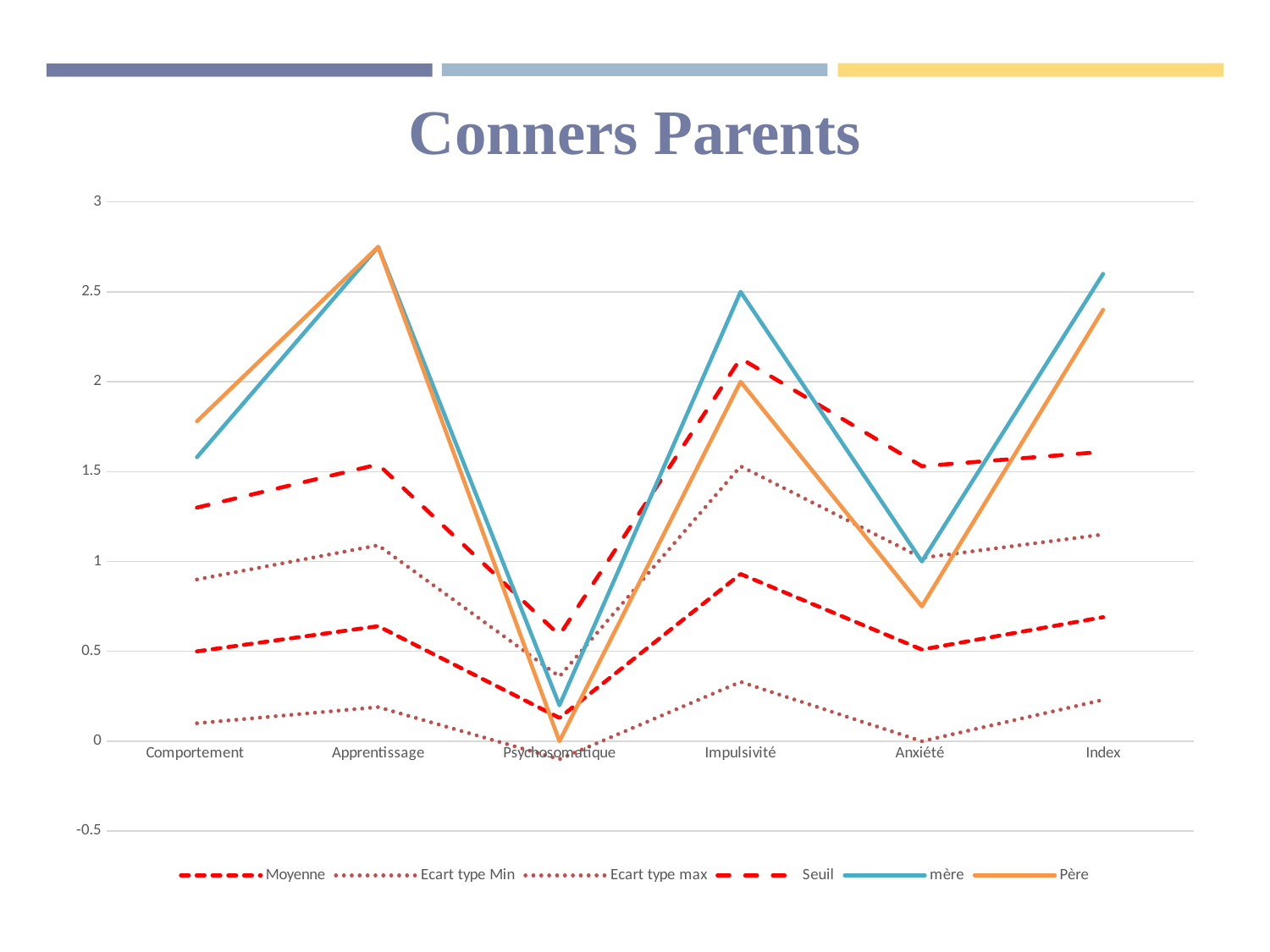
How many series does the legend list? 6 For the Père series, which category has the lowest value? Psychosomatique Is the value for mère at Psychosomatique greater or less than 0.5? less For the mère series, which category has the highest value? Apprentissage What is the value of the Père series at Psychosomatique? 0 At Index, which is larger: the mère value or the Père value? mère How many categories are shown on the x axis? 6 What is the title of the chart? Conners Parents What type of chart is shown on the slide? line chart At Comportement, which is larger: the mère value or the Père value? Père Is the value for Père at Comportement greater or less than 1.5? greater What is the value of the mère series at Impulsivité? 2.5